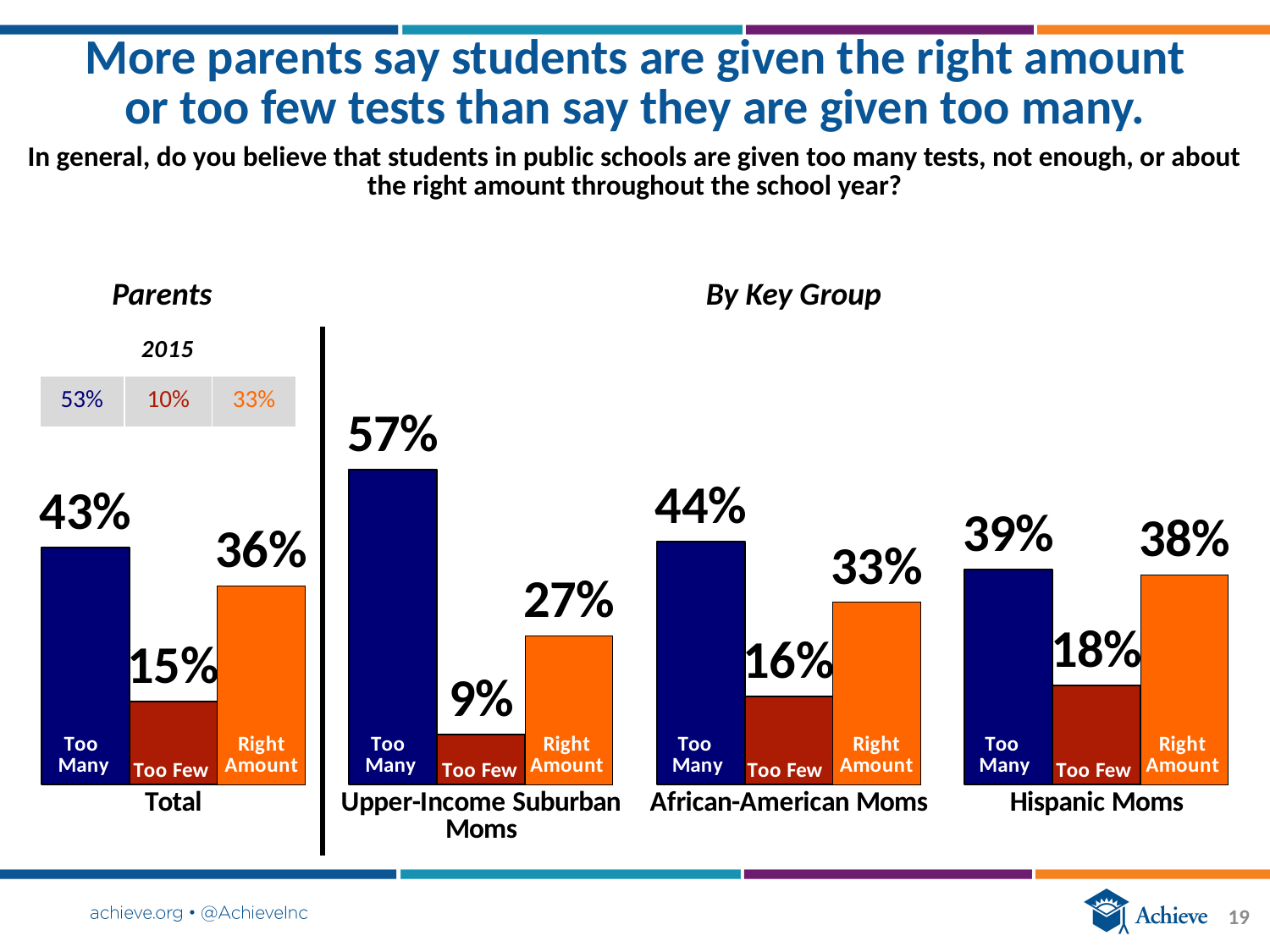
Which group has the highest 'Too Many' value? Upper-Income Suburban Moms In the 2015 table for Parents, what was the 'Too Many' value? 53% What is the difference between the 'Too Many' and 'Right Amount' values for Hispanic Moms? 1% What is the 'Too Few' value for African-American Moms? 16% What kind of chart is shown on the slide? Bar chart What percentage of the Total group say students are given too many tests? 43% Which is larger for African-American Moms: 'Too Many' or 'Right Amount'? Too Many What is the difference between the 'Too Many' and 'Too Few' values for the Total group? 28% What is the 'Too Many' value for Hispanic Moms? 39% How many key groups are shown in the chart, including Total? 4 What is the 'Right Amount' value for Upper-Income Suburban Moms? 27% Which group has the lowest 'Too Few' value? Upper-Income Suburban Moms